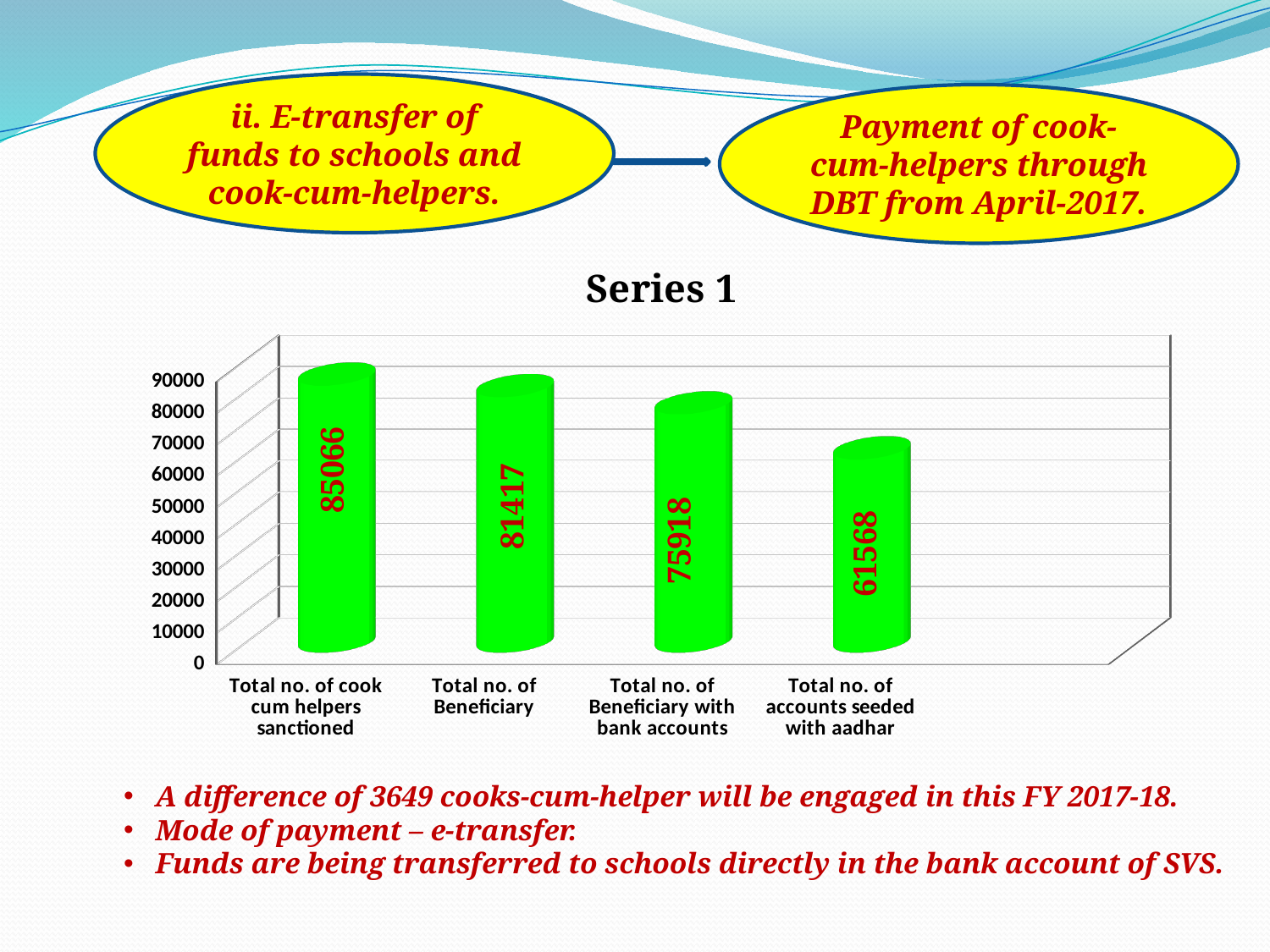
What is the value for Total no. of accounts seeded with aadhar? 61568 What is the value for Total no. of Beneficiary? 81417 Do the values rise or fall from left to right across the categories? Fall What is the value for Total no. of cook cum helpers sanctioned? 85066 What is the difference between Total no. of Beneficiary with bank accounts and Total no. of accounts seeded with aadhar? 14350 What is the difference between Total no. of cook cum helpers sanctioned and Total no. of Beneficiary? 3649 Which category has the lowest value? Total no. of accounts seeded with aadhar How many categories are shown in the chart? 4 What is the value for Total no. of Beneficiary with bank accounts? 75918 Which is larger: Total no. of Beneficiary or Total no. of Beneficiary with bank accounts? Total no. of Beneficiary What kind of chart is shown on the slide? Bar chart Which category has the highest value? Total no. of cook cum helpers sanctioned